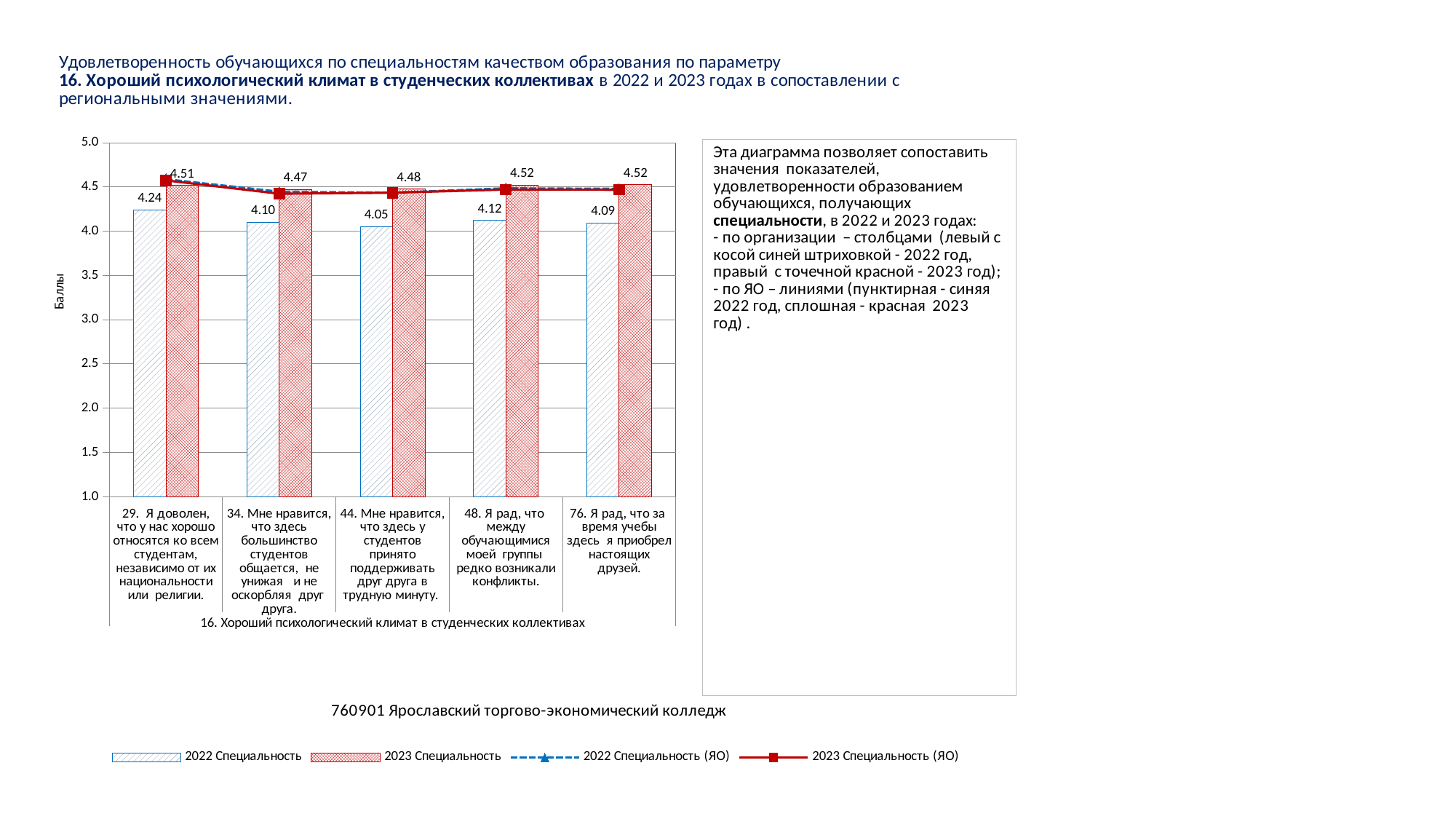
Which category has the highest 2022 Специальность value? 29. Я доволен, что у нас хорошо относятся ко всем студентам, независимо от их национальности или религии. How many series does the legend list? 4 How many categories are shown on the x axis? 5 What kind of chart is this? Bar chart with line series What is the label of the y axis? Баллы What is the difference between the 2023 and 2022 Специальность values for category 44? 0.43 What is the 2023 Специальность value for category 48 (Я рад, что между обучающимися моей группы редко возникали конфликты)? 4.52 What is the 2022 Специальность value for category 29 (Я доволен, что у нас хорошо относятся ко всем студентам...)? 4.24 What is the 2022 Специальность value for category 44 (Мне нравится, что здесь у студентов принято поддерживать друг друга...)? 4.05 What is the 2023 Специальность value for category 34 (Мне нравится, что здесь большинство студентов общается...)? 4.47 Which category has the lowest 2022 Специальность value? 44. Мне нравится, что здесь у студентов принято поддерживать друг друга в трудную минуту. Which is larger for category 76: the 2022 Специальность value or the 2023 Специальность value? 2023 Специальность